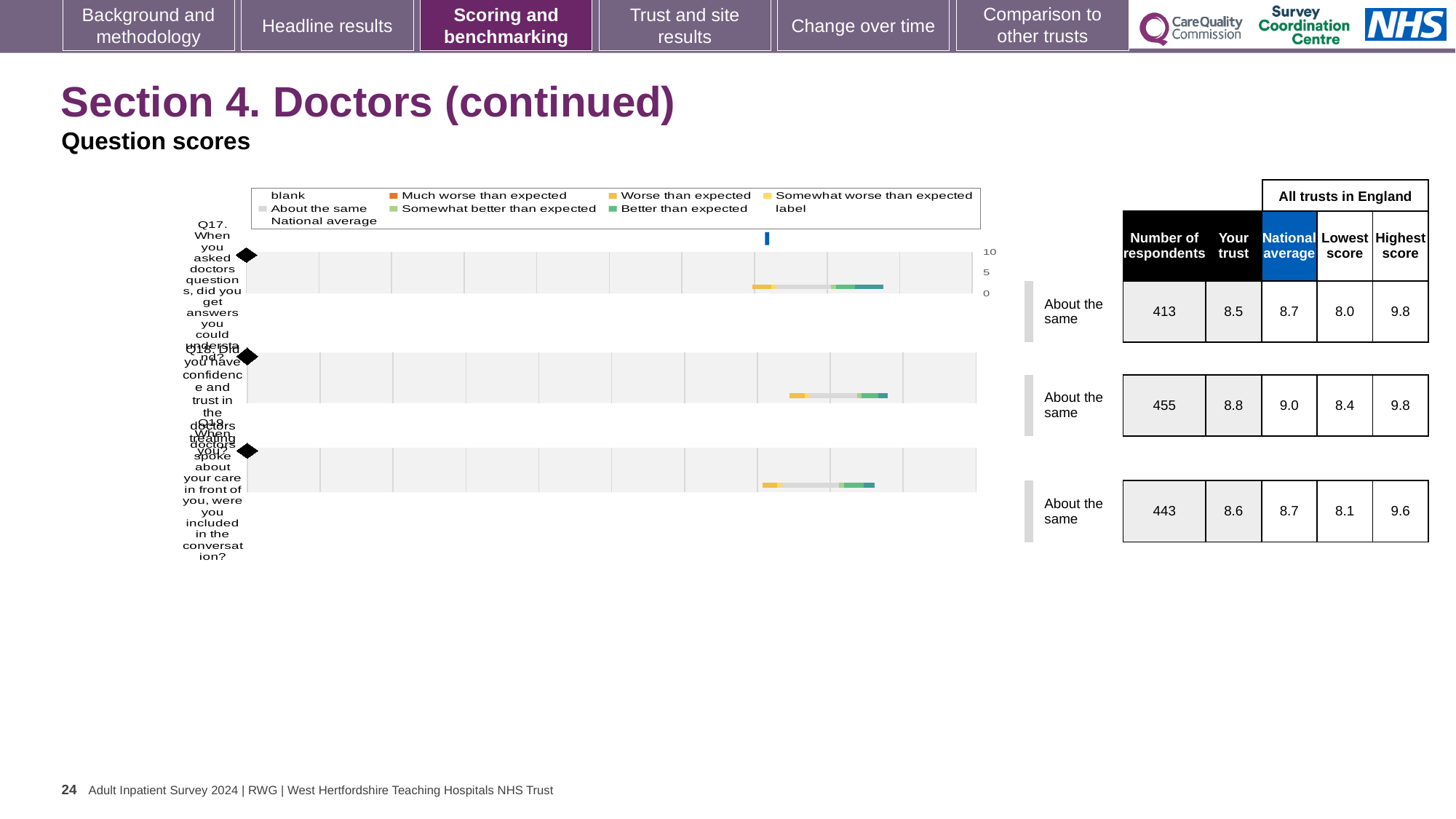
Is the 'Your trust' score for Q17 higher or lower than the national average for Q17? lower Which question has the highest 'Your trust' score? Q18 Which question has the lowest number of respondents? Q17 What benchmark category is shown for Q17, Q18 and Q19? About the same How many questions (categories) are plotted in the chart? 3 What is the lowest score across all trusts in England for Q18? 8.4 What is the number of respondents for Q19 (When doctors spoke about your care in front of you, were you included in the conversation)? 443 What is the highest score across all trusts in England for Q19? 9.6 What is the difference between the national average and the 'Your trust' score for Q18? 0.2 What is the national average score for Q18 (Did you have confidence and trust in the doctors treating you)? 9.0 What is the 'Your trust' score for Q17 (When you asked doctors questions, did you get answers you could understand)? 8.5 What kind of chart is shown on the slide? bar chart